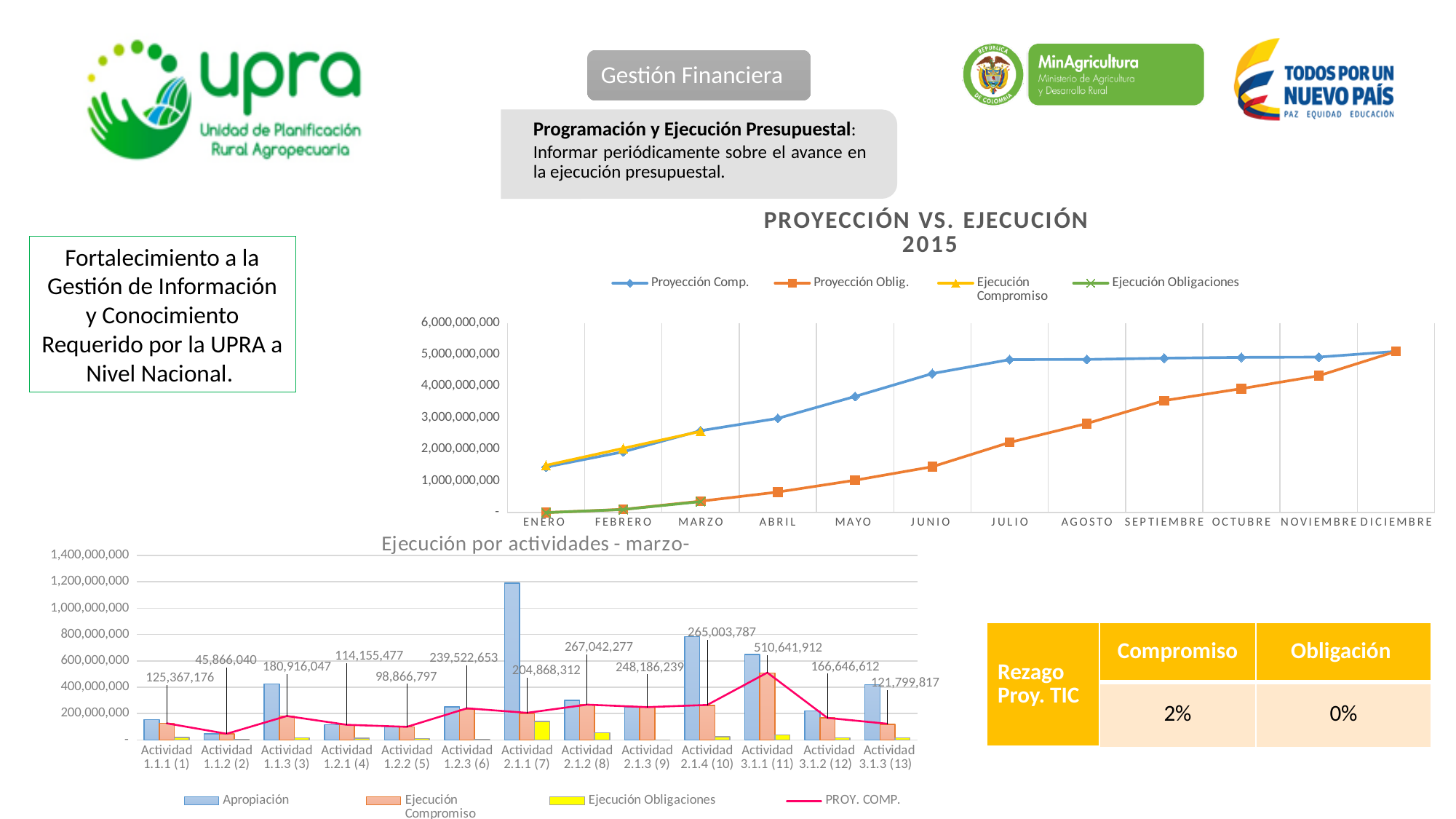
In the 'Ejecución por actividades - marzo-' chart, is the Apropiación value for Actividad 2.1.1 (7) greater or less than 1,000,000,000? greater In the 'Ejecución por actividades - marzo-' chart, what is the PROY. COMP. value labelled for Actividad 3.1.1 (11)? 510,641,912 How many months are shown on the x axis of the 'PROYECCIÓN VS. EJECUCIÓN 2015' chart? 12 In the 'PROYECCIÓN VS. EJECUCIÓN 2015' chart, does the Proyección Oblig. series rise or fall from Enero to Diciembre? rise How many series does the legend of the 'PROYECCIÓN VS. EJECUCIÓN 2015' chart list? 4 How many activities are shown on the x axis of the 'Ejecución por actividades - marzo-' chart? 13 In the 'Ejecución por actividades - marzo-' chart, which activity has the lowest labelled PROY. COMP. value? Actividad 1.1.2 (2) In the 'PROYECCIÓN VS. EJECUCIÓN 2015' chart, which is larger in Junio: Proyección Comp. or Proyección Oblig.? Proyección Comp. In the 'PROYECCIÓN VS. EJECUCIÓN 2015' chart, is the Proyección Oblig. value for Mayo greater or less than 2,000,000,000? less In the 'Ejecución por actividades - marzo-' chart, what is the difference between the labelled PROY. COMP. values for Actividad 3.1.1 (11) and Actividad 2.1.2 (8)? 243,599,635 What type of chart is the 'PROYECCIÓN VS. EJECUCIÓN 2015' chart? line chart In the 'PROYECCIÓN VS. EJECUCIÓN 2015' chart, is the Proyección Comp. value for Julio greater or less than 4,000,000,000? greater